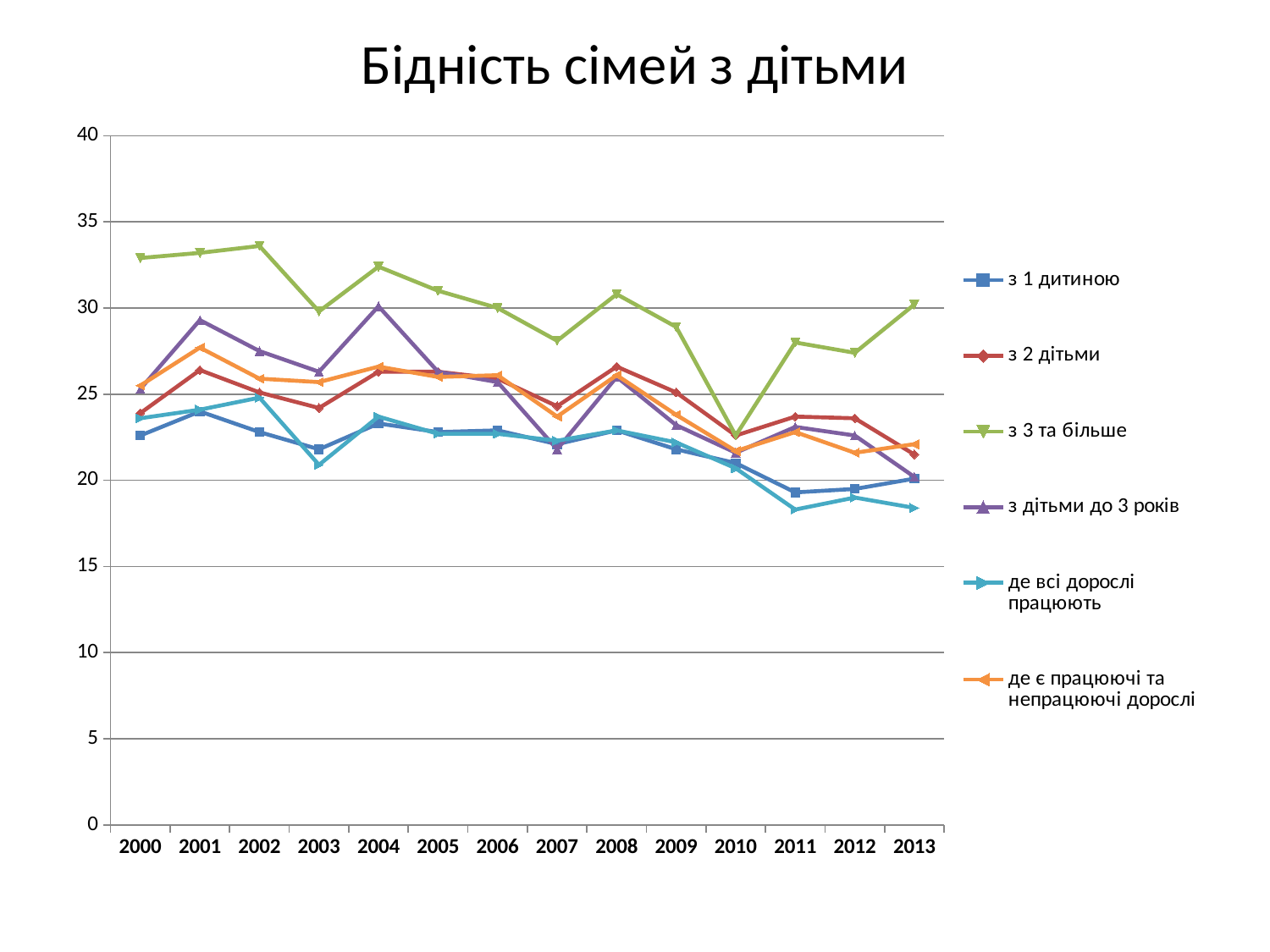
What is the title of the chart? Бідність сімей з дітьми Is the value for 'з дітьми до 3 років' in 2007 greater or less than 25? less How many series does the legend list? 6 How many years are shown on the x axis? 14 What kind of chart is shown on the slide? line chart In 2011, which is larger: the value for 'з 3 та більше' or the value for 'з 2 дітьми'? з 3 та більше Does the value for 'де всі дорослі працюють' rise or fall from 2008 to 2011? fall Is the value for 'з 3 та більше' in 2002 greater or less than 30? greater In which year does the series 'з 3 та більше' reach its lowest value? 2010 Which series has the lowest value in 2013? де всі дорослі працюють Is the value for 'де всі дорослі працюють' in 2011 greater or less than 20? less Which series has the highest value in 2000? з 3 та більше